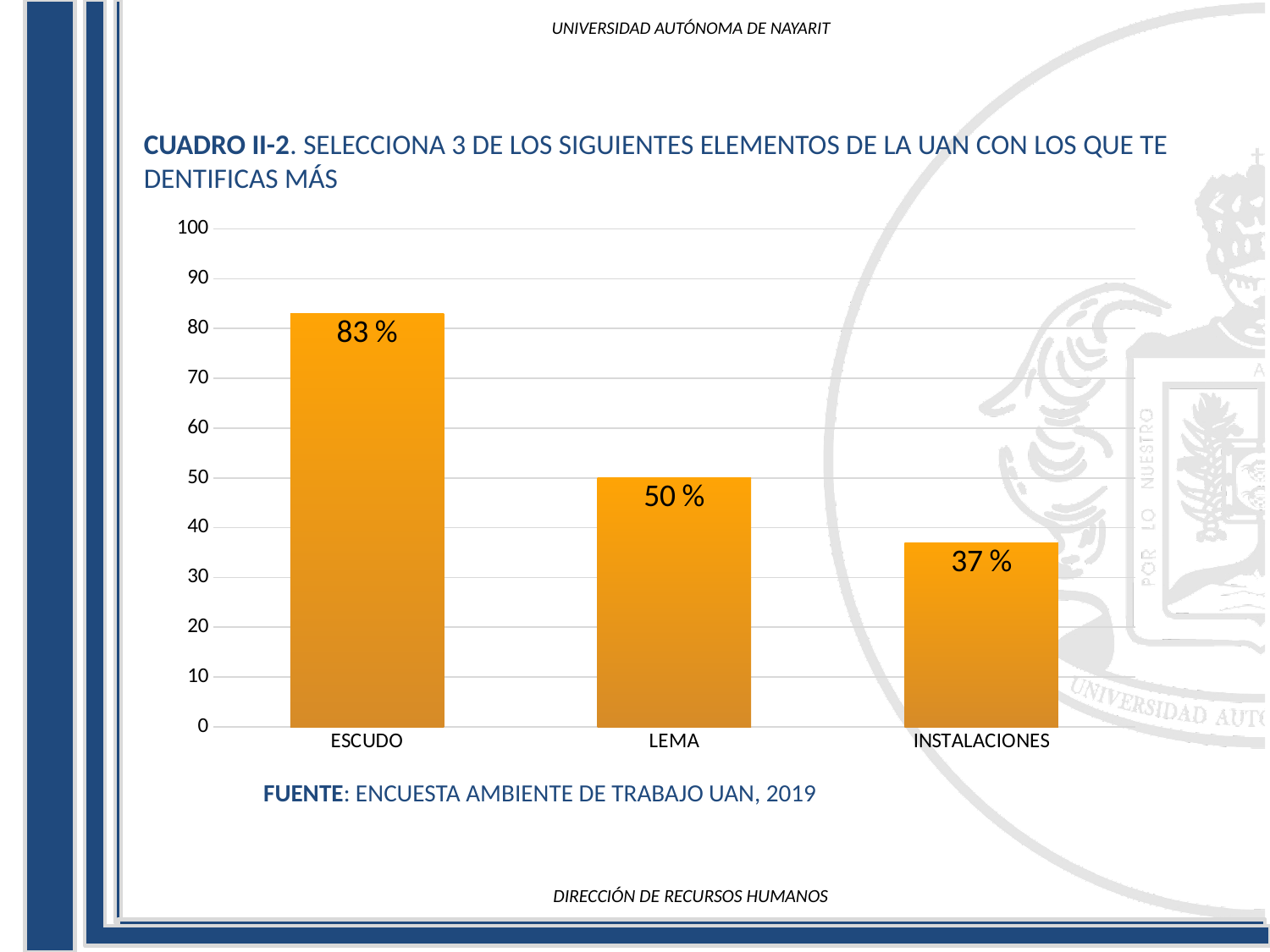
Do the values rise or fall from left to right along the x axis? fall What is the difference between the values for LEMA and INSTALACIONES? 13 % What is the value for LEMA? 50 % Which category has the lowest value? INSTALACIONES What is the difference between the values for ESCUDO and LEMA? 33 % Is the value for ESCUDO greater or less than 80? greater Which category has the highest value? ESCUDO Which is larger, the value for LEMA or the value for INSTALACIONES? LEMA What is the value for INSTALACIONES? 37 % What kind of chart is shown on the slide? bar chart What is the value for ESCUDO? 83 % How many categories are shown on the chart? 3